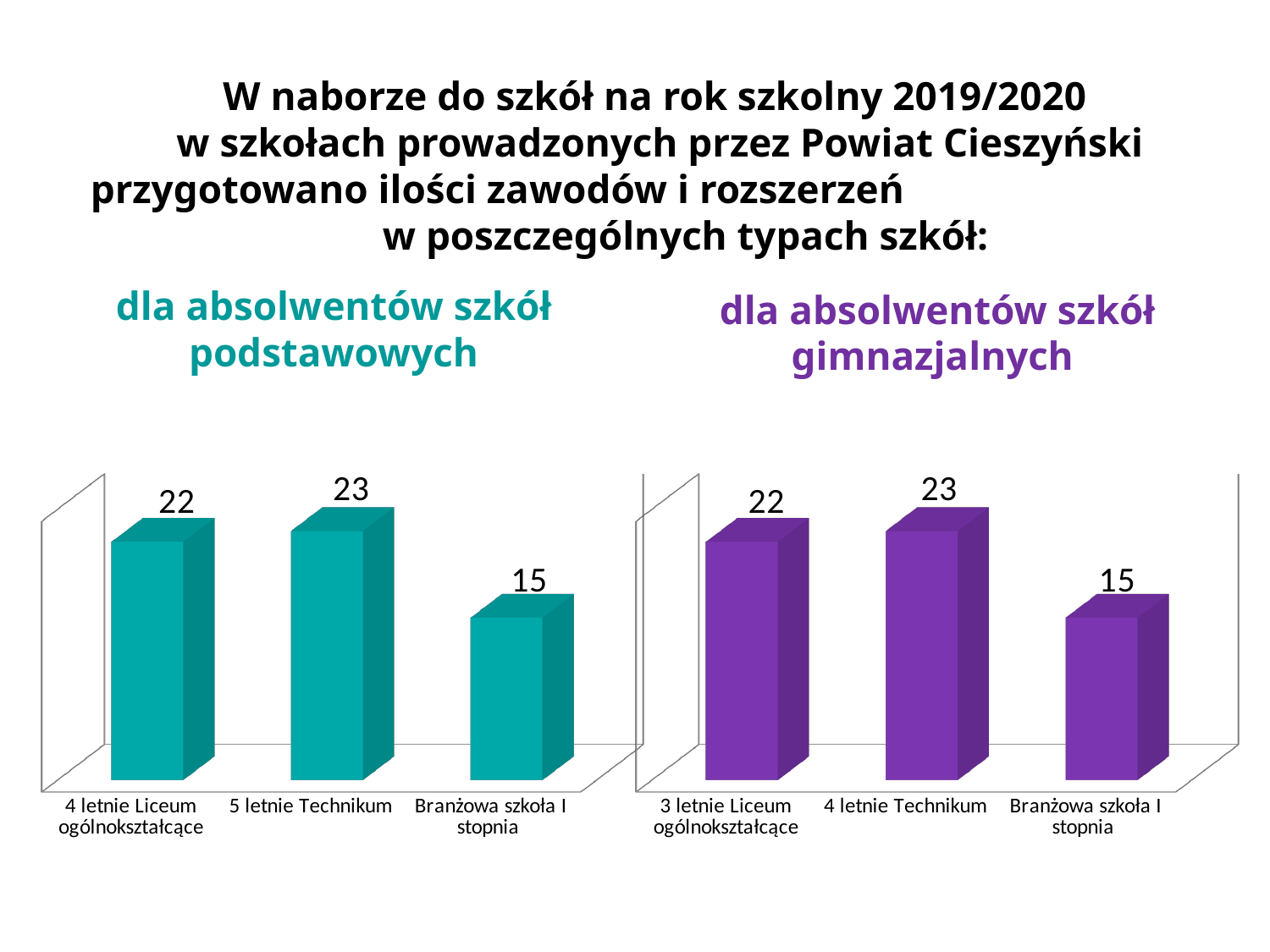
In the right chart (dla absolwentów szkół gimnazjalnych), which category has the highest value? 4 letnie Technikum In the right chart (dla absolwentów szkół gimnazjalnych), what is the difference between the values for 4 letnie Technikum and 3 letnie Liceum ogólnokształcące? 1 In the right chart (dla absolwentów szkół gimnazjalnych), what is the value for 4 letnie Technikum? 23 In the left chart (dla absolwentów szkół podstawowych), which category has the lowest value? Branżowa szkoła I stopnia What type of chart is the left chart (dla absolwentów szkół podstawowych)? Bar chart In the left chart (dla absolwentów szkół podstawowych), which is larger: the value for 4 letnie Liceum ogólnokształcące or Branżowa szkoła I stopnia? 4 letnie Liceum ogólnokształcące In the left chart (dla absolwentów szkół podstawowych), what is the value for 5 letnie Technikum? 23 In the left chart (dla absolwentów szkół podstawowych), what is the difference between the values for 5 letnie Technikum and Branżowa szkoła I stopnia? 8 In the right chart (dla absolwentów szkół gimnazjalnych), what is the value for 3 letnie Liceum ogólnokształcące? 22 How many categories are shown in the right chart (dla absolwentów szkół gimnazjalnych)? 3 In the left chart (dla absolwentów szkół podstawowych), what is the value for Branżowa szkoła I stopnia? 15 What colour are the bars in the right chart (dla absolwentów szkół gimnazjalnych)? Purple